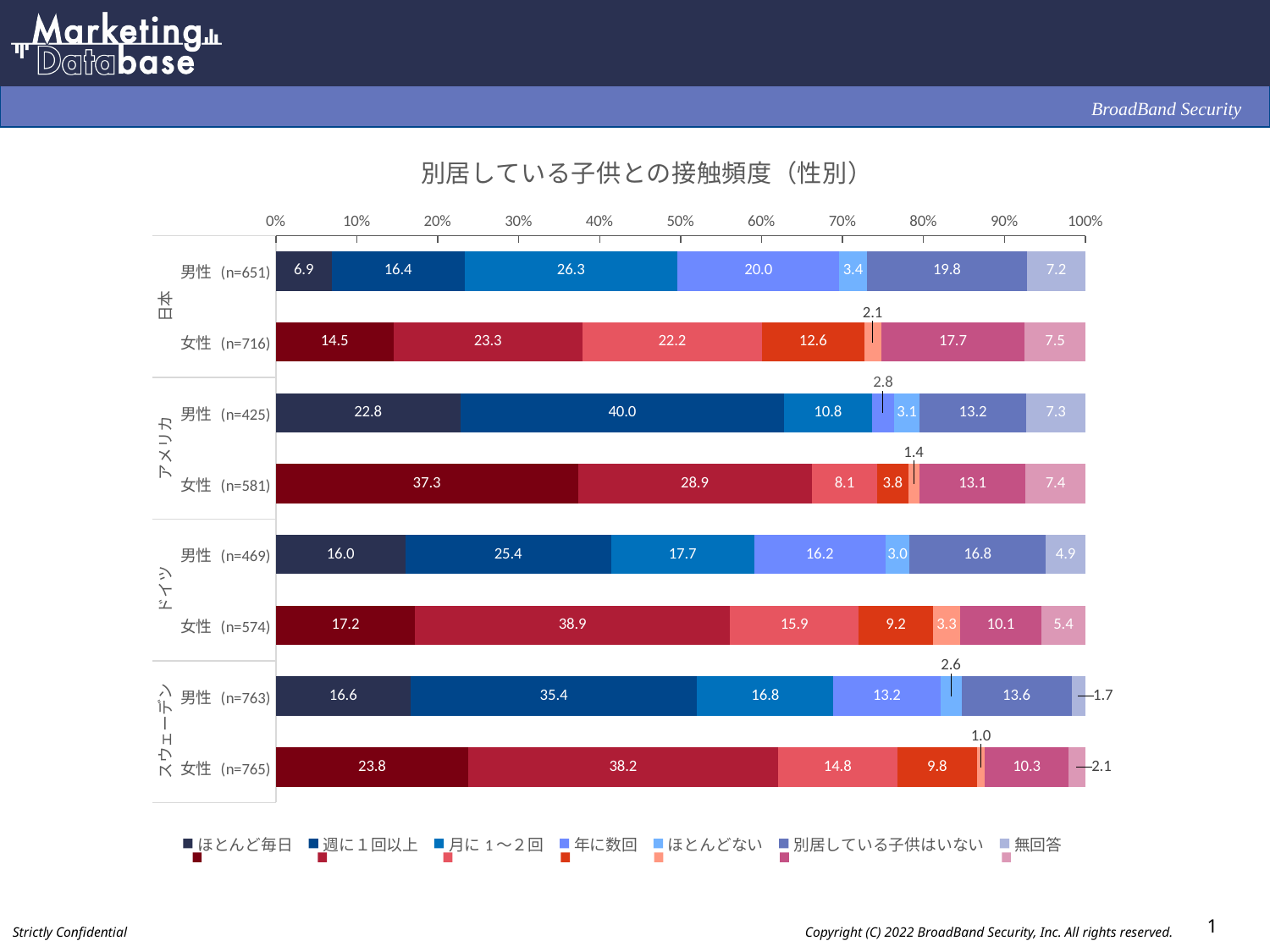
Which is larger: the 年に数回 value for 日本 男性 (n=651) or for 日本 女性 (n=716)? 日本 男性 (n=651) What is the value of ほとんど毎日 for アメリカ 女性 (n=581)? 37.3 How many bars (country-gender groups) are plotted in the chart? 8 Which group has the highest value for ほとんど毎日? アメリカ 女性 (n=581) What is the value of 無回答 for スウェーデン 男性 (n=763)? 1.7 Which group has the lowest value for ほとんど毎日? 日本 男性 (n=651) What is the difference between the 週に１回以上 values for ドイツ 女性 (n=574) and ドイツ 男性 (n=469)? 13.5 What is the value of 週に１回以上 for アメリカ 男性 (n=425)? 40.0 What kind of chart is shown on the slide? Stacked bar chart What is the title of the chart? 別居している子供との接触頻度（性別） What is the value of 月に１〜２回 for 日本 男性 (n=651)? 26.3 How many series does the legend list? 7